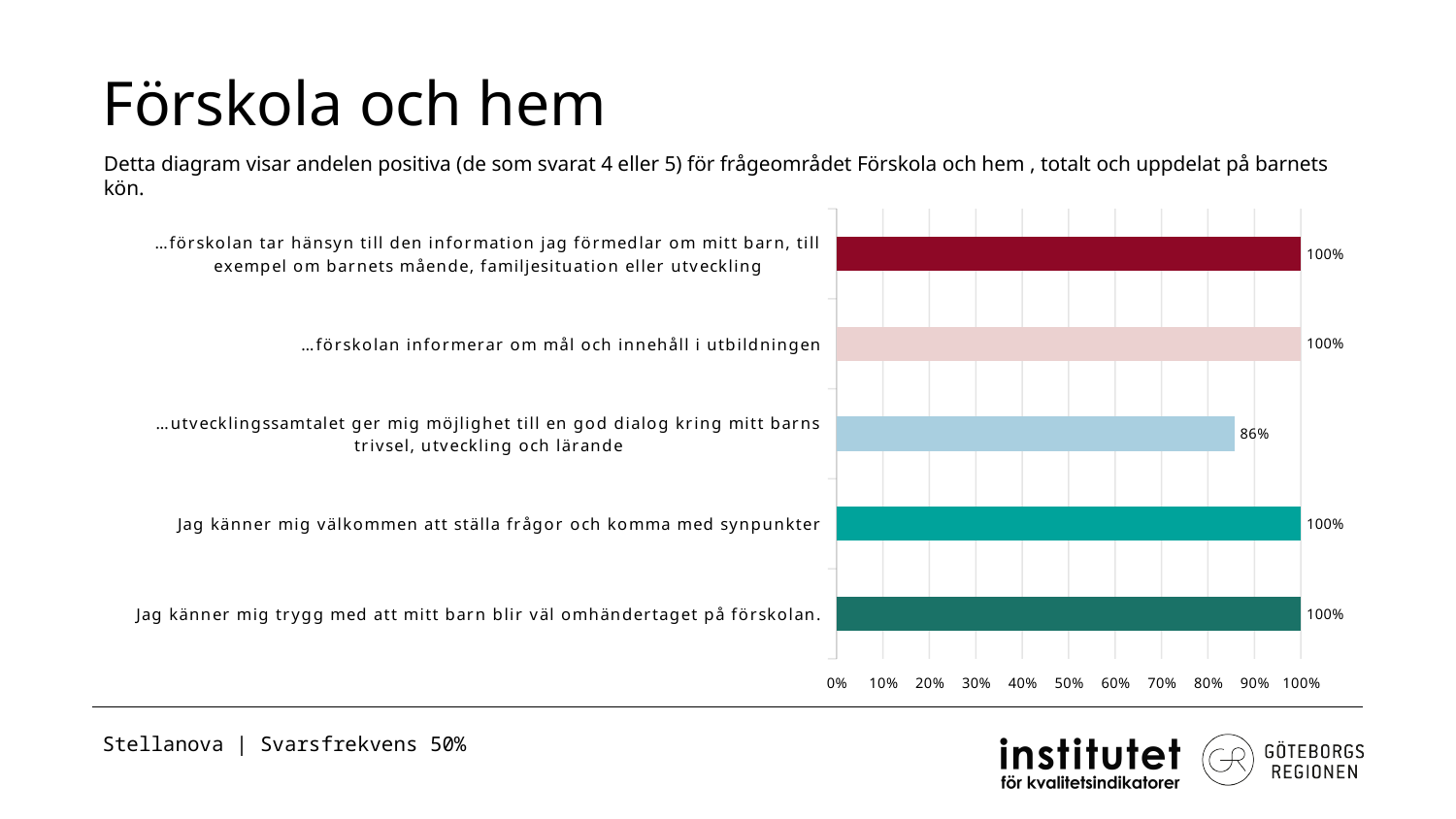
How many categories are shown in the chart? 5 Which is larger: the value for "Jag känner mig välkommen att ställa frågor och komma med synpunkter" or the value for "…utvecklingssamtalet ger mig möjlighet till en god dialog kring mitt barns trivsel, utveckling och lärande"? Jag känner mig välkommen att ställa frågor och komma med synpunkter What kind of chart is shown on the slide? bar chart What is the value for "…förskolan informerar om mål och innehåll i utbildningen"? 100% Which category has the lowest value? …utvecklingssamtalet ger mig möjlighet till en god dialog kring mitt barns trivsel, utveckling och lärande What is the title of the slide containing the chart? Förskola och hem Is the value for "…utvecklingssamtalet ger mig möjlighet till en god dialog kring mitt barns trivsel, utveckling och lärande" greater or less than 90%? less What is the value for "…utvecklingssamtalet ger mig möjlighet till en god dialog kring mitt barns trivsel, utveckling och lärande"? 86% What is the value for "Jag känner mig välkommen att ställa frågor och komma med synpunkter"? 100% What is the difference between the value for "…förskolan informerar om mål och innehåll i utbildningen" and the value for "…utvecklingssamtalet ger mig möjlighet till en god dialog kring mitt barns trivsel, utveckling och lärande"? 14% What is the value for "Jag känner mig trygg med att mitt barn blir väl omhändertaget på förskolan."? 100% How many categories have a value of 100%? 4